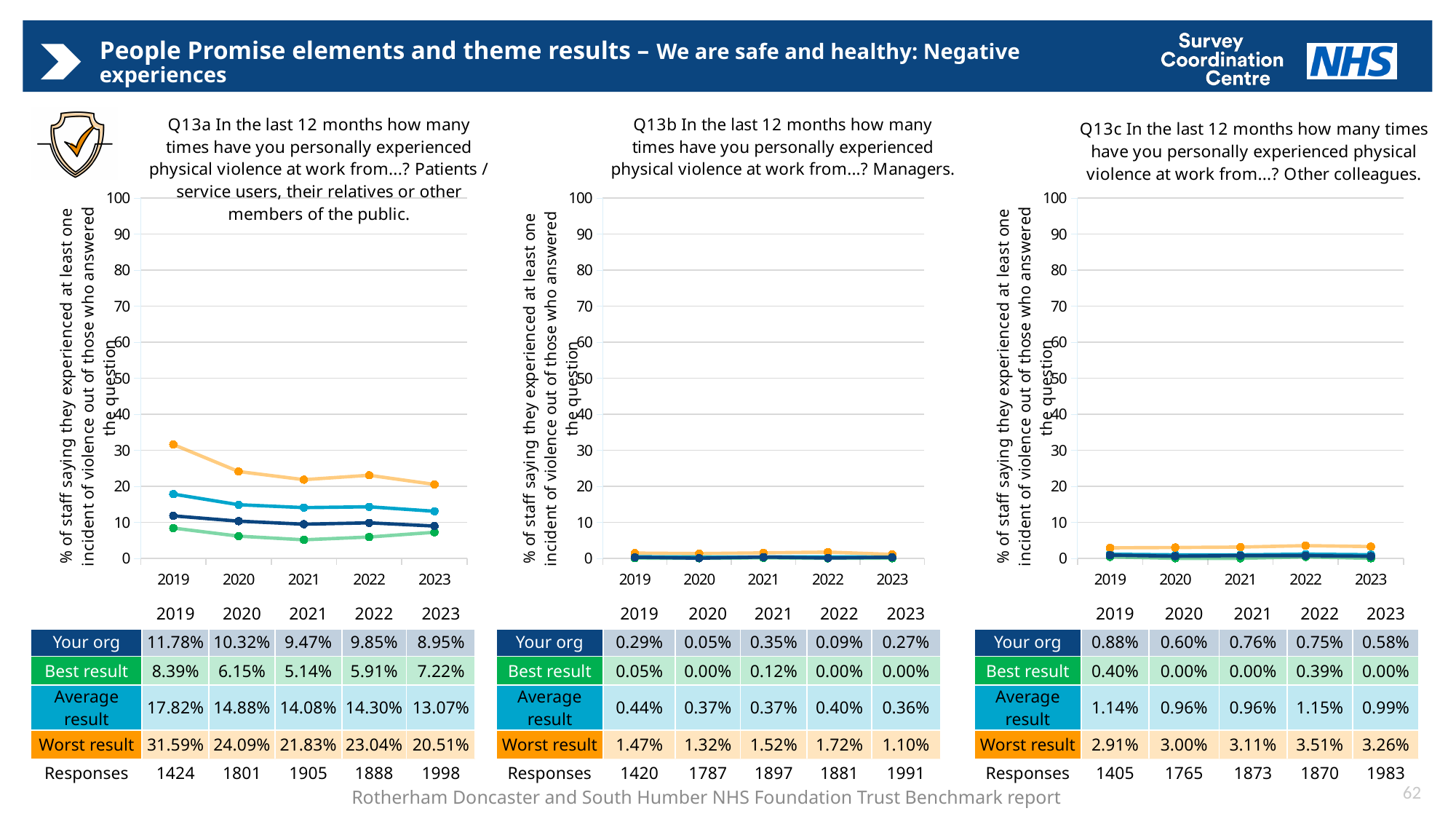
In the Q13c chart, which year has the larger Worst result value, 2022 or 2023? 2022 In the Q13a chart, what is the difference between the Worst result values for 2019 and 2023? 11.08 percentage points In the Q13a chart, in which year is the Worst result value highest? 2019 How many series (lines) are plotted in the Q13a chart? 4 In the Q13a chart, in which year is the Your org value lowest? 2023 In the Q13b chart (physical violence from managers), what is the Worst result value for 2022? 1.72% In the Q13a chart, does the Your org value overall rise or fall from 2019 to 2023? Fall In the Q13c chart (physical violence from other colleagues), what is the Average result value for 2019? 1.14% What kind of chart is the Q13c chart? Line chart In the Q13a chart, is the Worst result value for 2019 greater or less than 30? greater How many years are shown on the x axis of the Q13b chart? 5 In the Q13a chart (physical violence from patients / service users), what is the Your org value for 2023? 8.95%